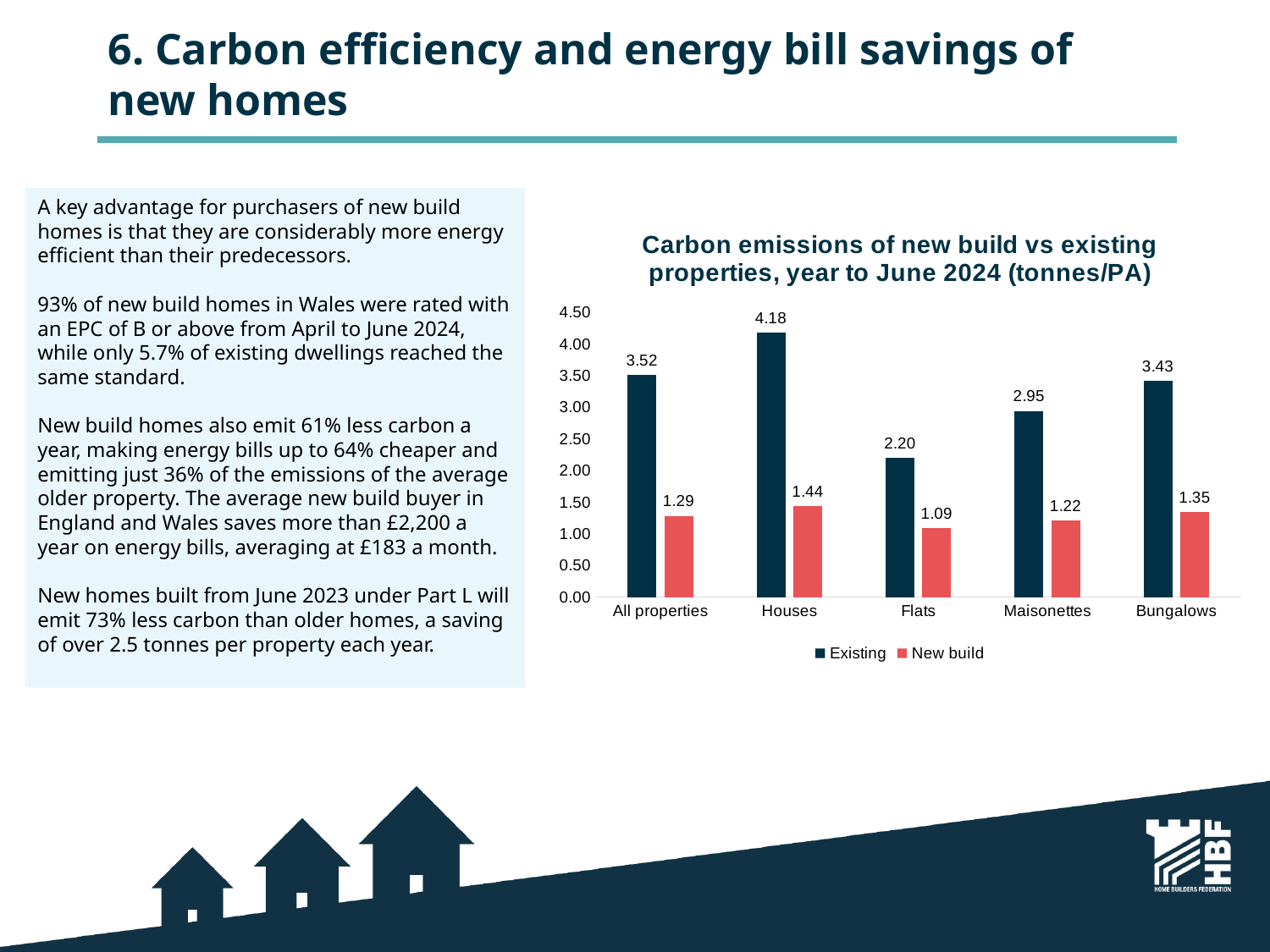
What is the New build value for Flats? 1.09 What kind of chart is shown? bar chart How many categories are shown on the x axis? 5 Which category has the lowest New build value? Flats What is the title of the chart? Carbon emissions of new build vs existing properties, year to June 2024 (tonnes/PA) Which is larger, the New build value for Houses or the New build value for Bungalows? Houses Is the Existing value for Maisonettes greater or less than 2.50? greater Which category has the highest Existing value? Houses What is the Existing value for Bungalows? 3.43 How many series does the legend list? 2 What is the difference between the Existing and New build values for All properties? 2.23 What is the Existing value for Houses? 4.18